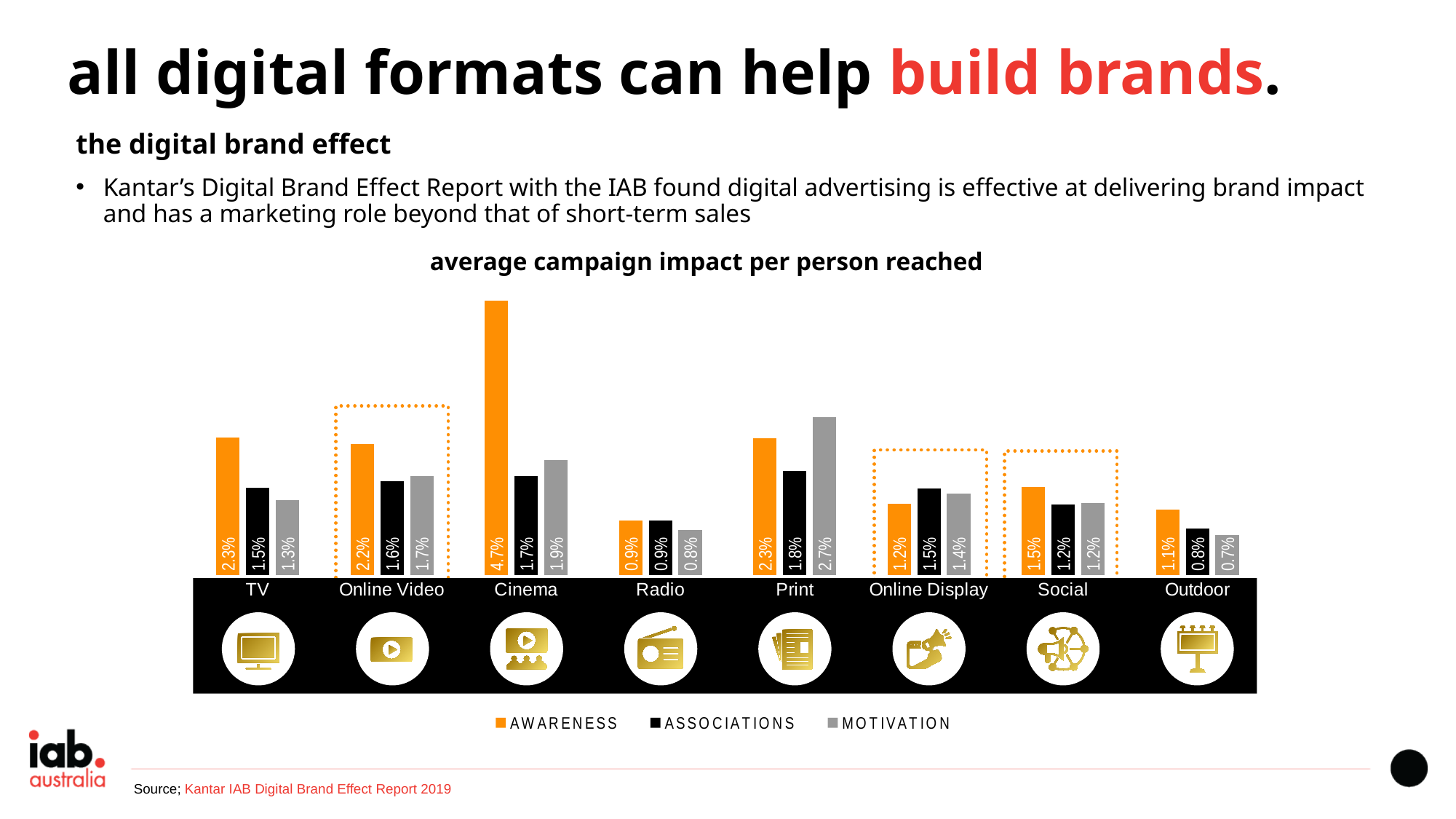
How many series does the legend list? 3 Which category has the lowest Motivation value? Outdoor What is the Associations value for Online Display? 1.5% Which is larger for Print: the Awareness value or the Motivation value? Motivation What is the difference between the Awareness values for Cinema and TV? 2.4% What is the title of the chart? average campaign impact per person reached What is the Awareness value for Outdoor? 1.1% Which category has the highest Awareness value? Cinema What is the Motivation value for Print? 2.7% What is the Awareness value for Cinema? 4.7% How many categories are shown on the x axis? 8 What kind of chart is shown on the slide? Bar chart